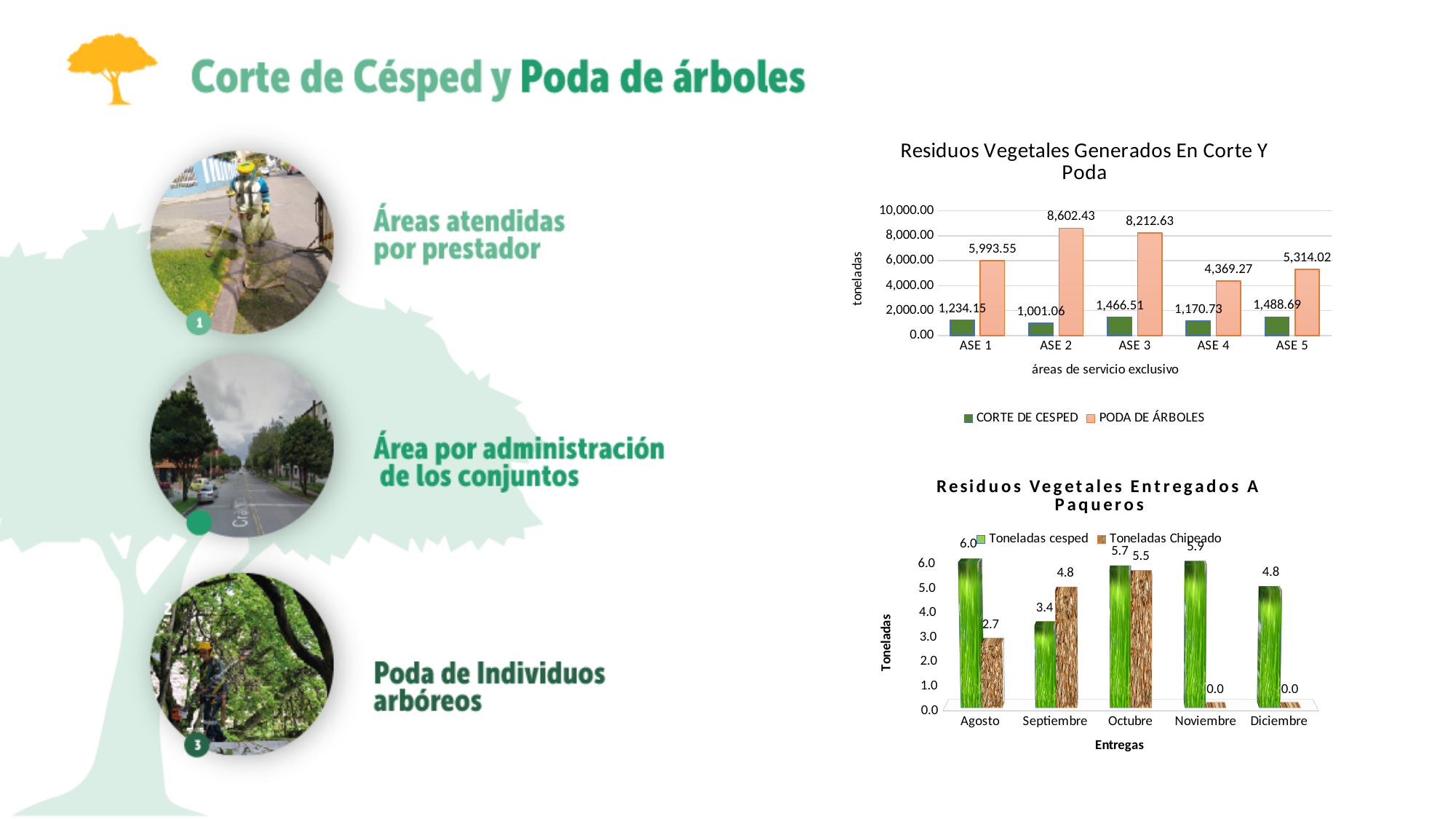
In the chart 'Residuos Vegetales Generados En Corte Y Poda', which ASE has the lowest CORTE DE CESPED value? ASE 2 In the chart 'Residuos Vegetales Generados En Corte Y Poda', what is the PODA DE ÁRBOLES value for ASE 2? 8,602.43 In the chart 'Residuos Vegetales Generados En Corte Y Poda', which ASE has the highest PODA DE ÁRBOLES value? ASE 2 In the chart 'Residuos Vegetales Entregados A Paqueros', what is the Toneladas cesped value for Noviembre? 5.9 In the chart 'Residuos Vegetales Entregados A Paqueros', what is the Toneladas Chipeado value for Septiembre? 4.8 In the chart 'Residuos Vegetales Generados En Corte Y Poda', what is the CORTE DE CESPED value for ASE 4? 1,170.73 In the chart 'Residuos Vegetales Generados En Corte Y Poda', what is the label of the y axis? toneladas In the chart 'Residuos Vegetales Entregados A Paqueros', how many months are shown on the x axis? 5 In the chart 'Residuos Vegetales Generados En Corte Y Poda', what is the difference between the PODA DE ÁRBOLES values for ASE 3 and ASE 4? 3,843.36 In the chart 'Residuos Vegetales Entregados A Paqueros', which month has the highest Toneladas cesped value? Agosto In the chart 'Residuos Vegetales Generados En Corte Y Poda', how many series does the legend list? 2 In the chart 'Residuos Vegetales Entregados A Paqueros', is the Toneladas cesped value for Septiembre larger or smaller than the Toneladas Chipeado value for Septiembre? smaller